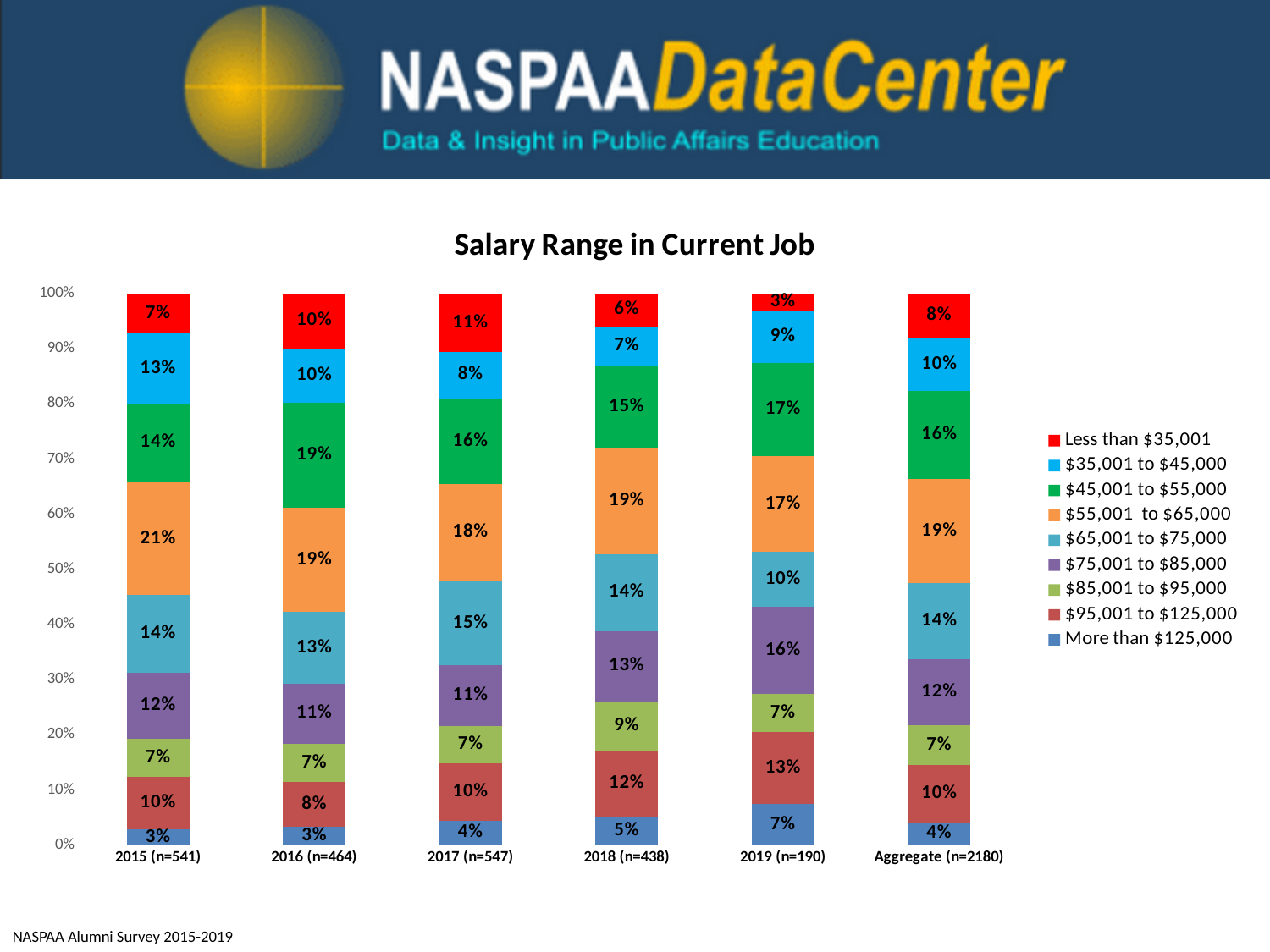
What is the title of the chart? Salary Range in Current Job How many series does the legend list? 9 How many bars (categories) are shown on the x axis? 6 What percentage of 2015 (n=541) respondents earned $55,001 to $65,000? 21% From 2015 to 2019, does the share of respondents earning more than $125,000 rise or fall? Rise Which is larger: the $45,001 to $55,000 share in 2016 (n=464) or in 2015 (n=541)? 2016 (n=464) What is the difference in percentage points between the $55,001 to $65,000 share in 2015 (n=541) and in 2019 (n=190)? 4 percentage points What percentage of 2019 (n=190) respondents earned $75,001 to $85,000? 16% Which year has the lowest share of respondents earning less than $35,001? 2019 (n=190) Which year has the highest share of respondents earning less than $35,001? 2017 (n=547) What kind of chart is shown on the slide? Stacked bar chart What is the value for 'More than $125,000' in the Aggregate (n=2180) bar? 4%